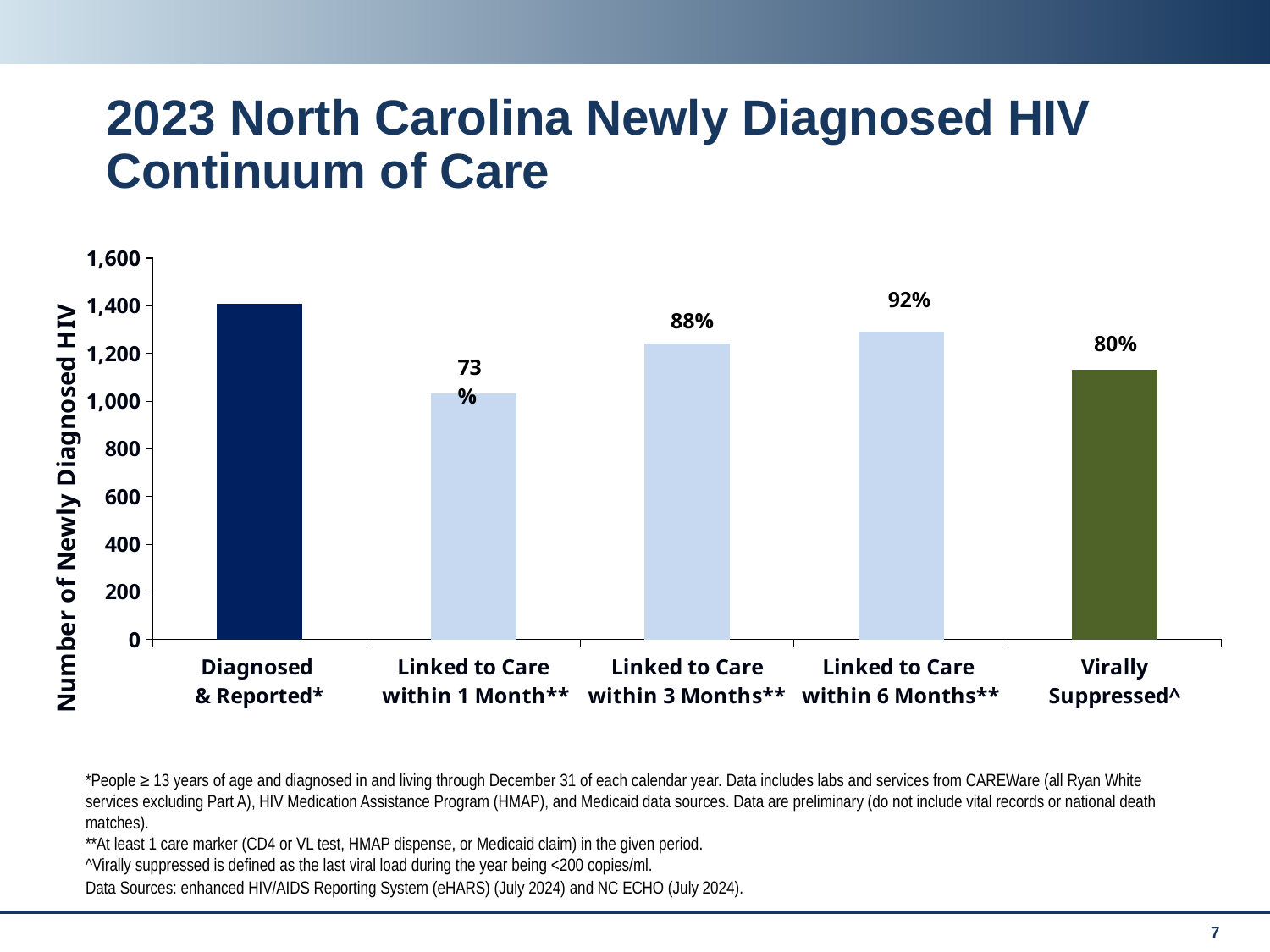
What kind of chart is shown on the slide? Bar chart What percentage label is shown above the 'Linked to Care within 6 Months**' bar? 92% What is the title of the chart on the slide? 2023 North Carolina Newly Diagnosed HIV Continuum of Care What percentage label is shown above the 'Virally Suppressed^' bar? 80% Is the value for 'Virally Suppressed^' greater or less than 1,200? less What percentage label is shown above the 'Linked to Care within 1 Month**' bar? 73% Is the value for 'Diagnosed & Reported*' greater or less than 1,200? greater How many categories are shown on the x axis of the chart? 5 Which category has the tallest bar? Diagnosed & Reported* Which bar is taller: 'Linked to Care within 3 Months**' or 'Linked to Care within 6 Months**'? Linked to Care within 6 Months** Which category has the shortest bar? Linked to Care within 1 Month** What percentage label is shown above the 'Linked to Care within 3 Months**' bar? 88%